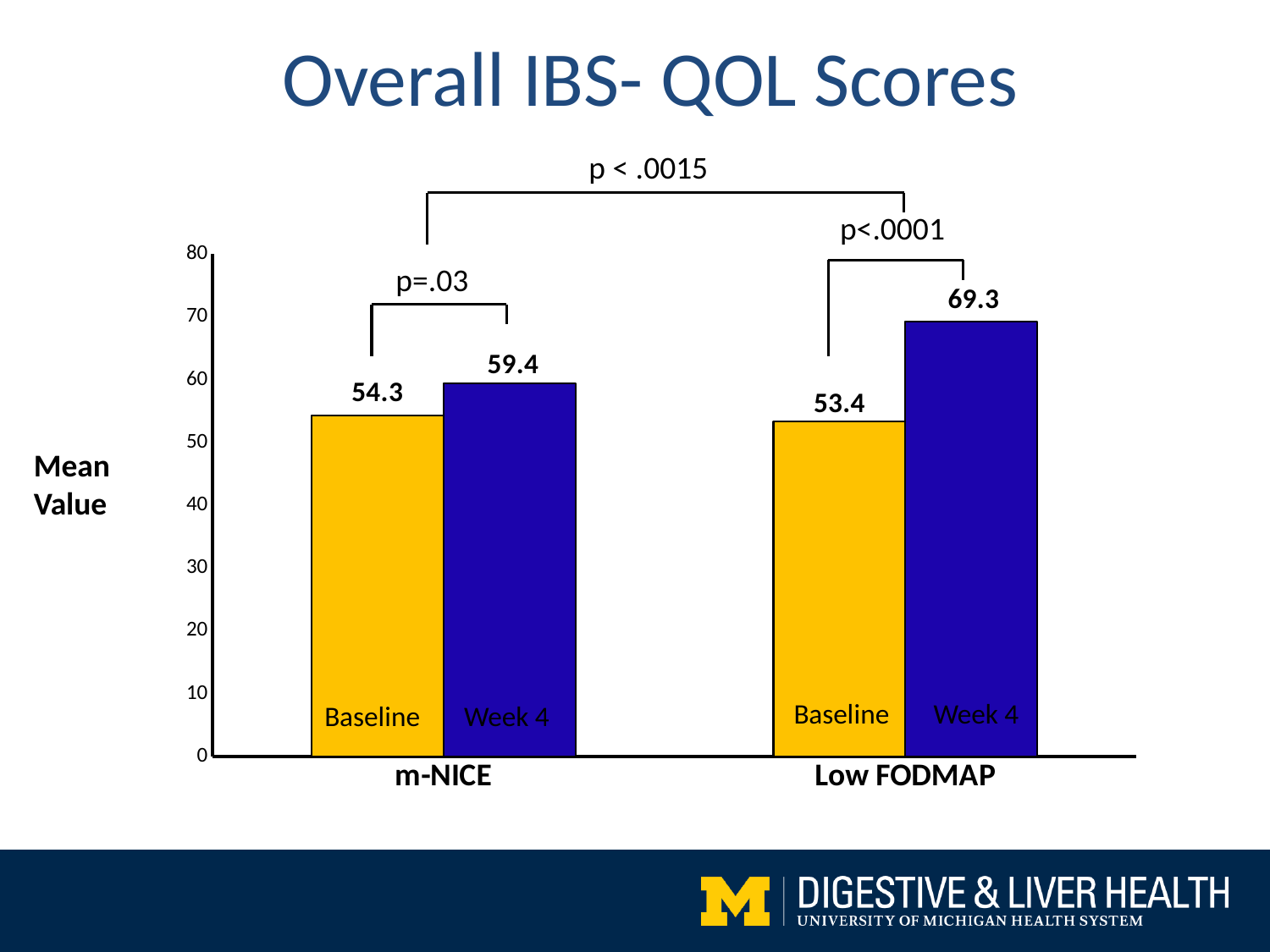
What is the Baseline mean value for the m-NICE group? 54.3 What is the difference between the Week 4 and Baseline mean values for the Low FODMAP group? 15.9 What kind of chart is shown on the slide? Bar chart What is the title of the chart? Overall IBS- QOL Scores What is the Week 4 mean value for the Low FODMAP group? 69.3 What is the Baseline mean value for the Low FODMAP group? 53.4 Which bar has the lowest mean value? Low FODMAP Baseline What is the difference between the Week 4 and Baseline mean values for the m-NICE group? 5.1 Which is larger, the Week 4 value for m-NICE or the Week 4 value for Low FODMAP? Low FODMAP Week 4 Is the Week 4 value for Low FODMAP greater or less than 60? greater Which bar has the highest mean value? Low FODMAP Week 4 What is the Week 4 mean value for the m-NICE group? 59.4